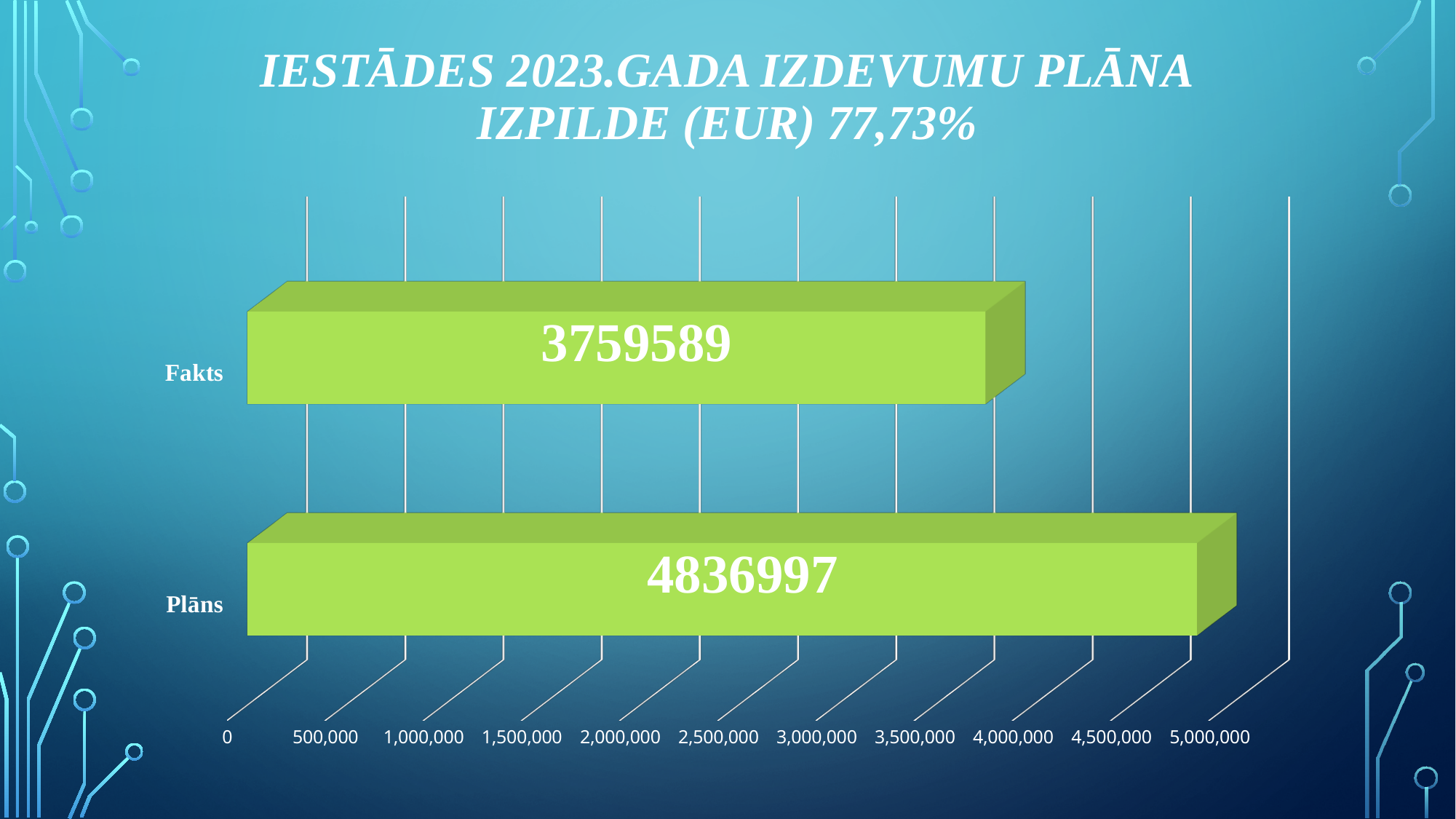
What kind of chart is shown on the slide? bar chart Is the value for Plāns greater or less than 4,500,000? greater Which category has the highest value? Plāns How many categories are shown in the chart? 2 What is the value for Fakts? 3759589 What is the maximum value shown on the horizontal axis? 5,000,000 What is the difference between the Plāns and Fakts values? 1077408 Which is larger, the value for Fakts or the value for Plāns? Plāns Which category has the lowest value? Fakts What is the value for Plāns? 4836997 What is the title of the chart? IESTĀDES 2023.GADA IZDEVUMU PLĀNA IZPILDE (EUR) 77,73% Is the value for Fakts greater or less than 4,000,000? less